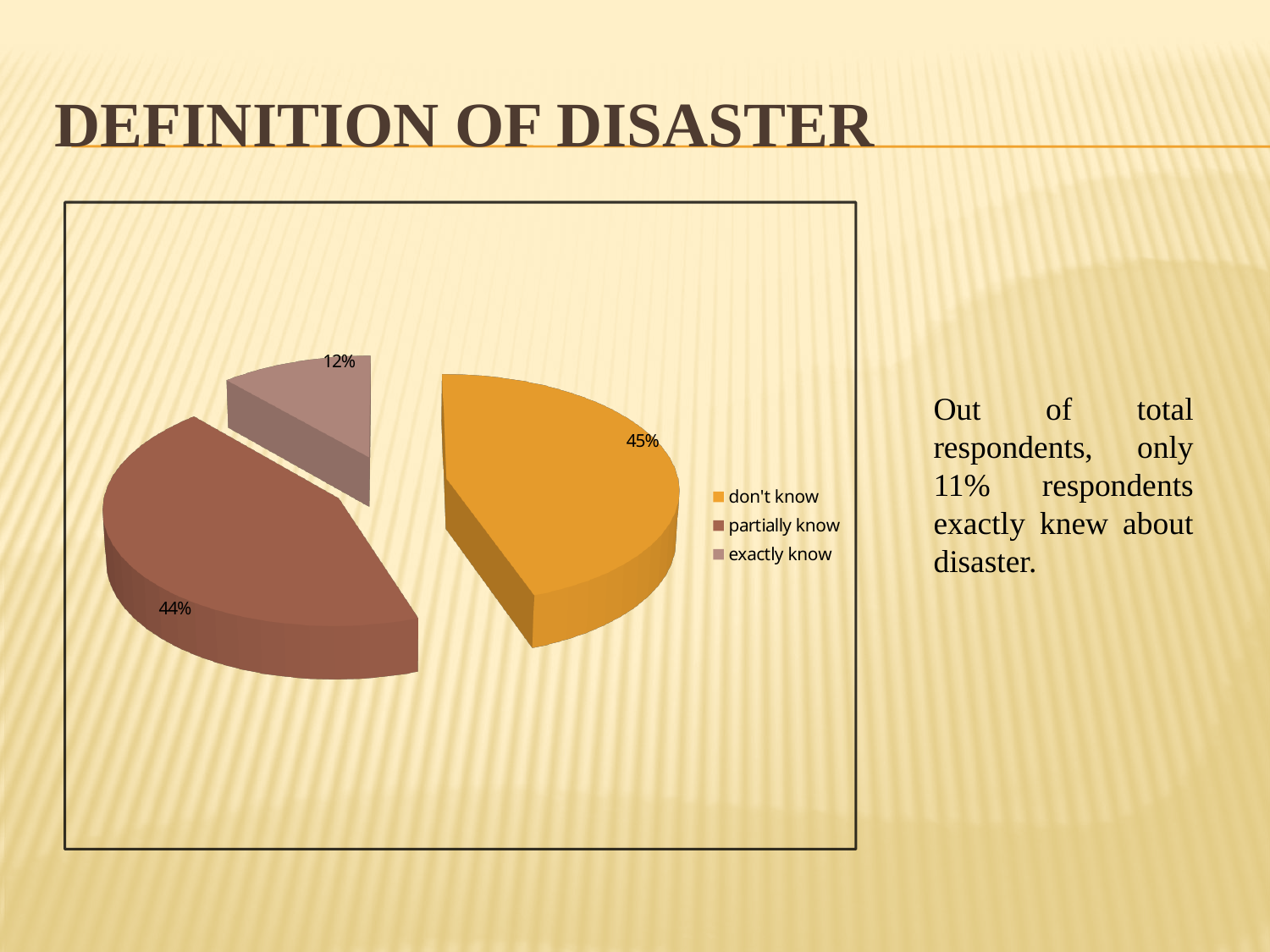
What colour is the "don't know" slice in the pie chart? orange What percentage of respondents fall in the "exactly know" category? 12% What type of chart is shown on the slide? pie chart How many slices does the pie chart have? 3 What is the difference in percentage points between "partially know" and "exactly know"? 32 Which category has the smallest share of the pie? exactly know Which is larger, the share for "partially know" or the share for "exactly know"? partially know What is the difference in percentage points between "don't know" and "exactly know"? 33 What percentage of respondents fall in the "don't know" category? 45% How many entries does the legend list? 3 What percentage of respondents fall in the "partially know" category? 44% Which category has the largest share of the pie? don't know